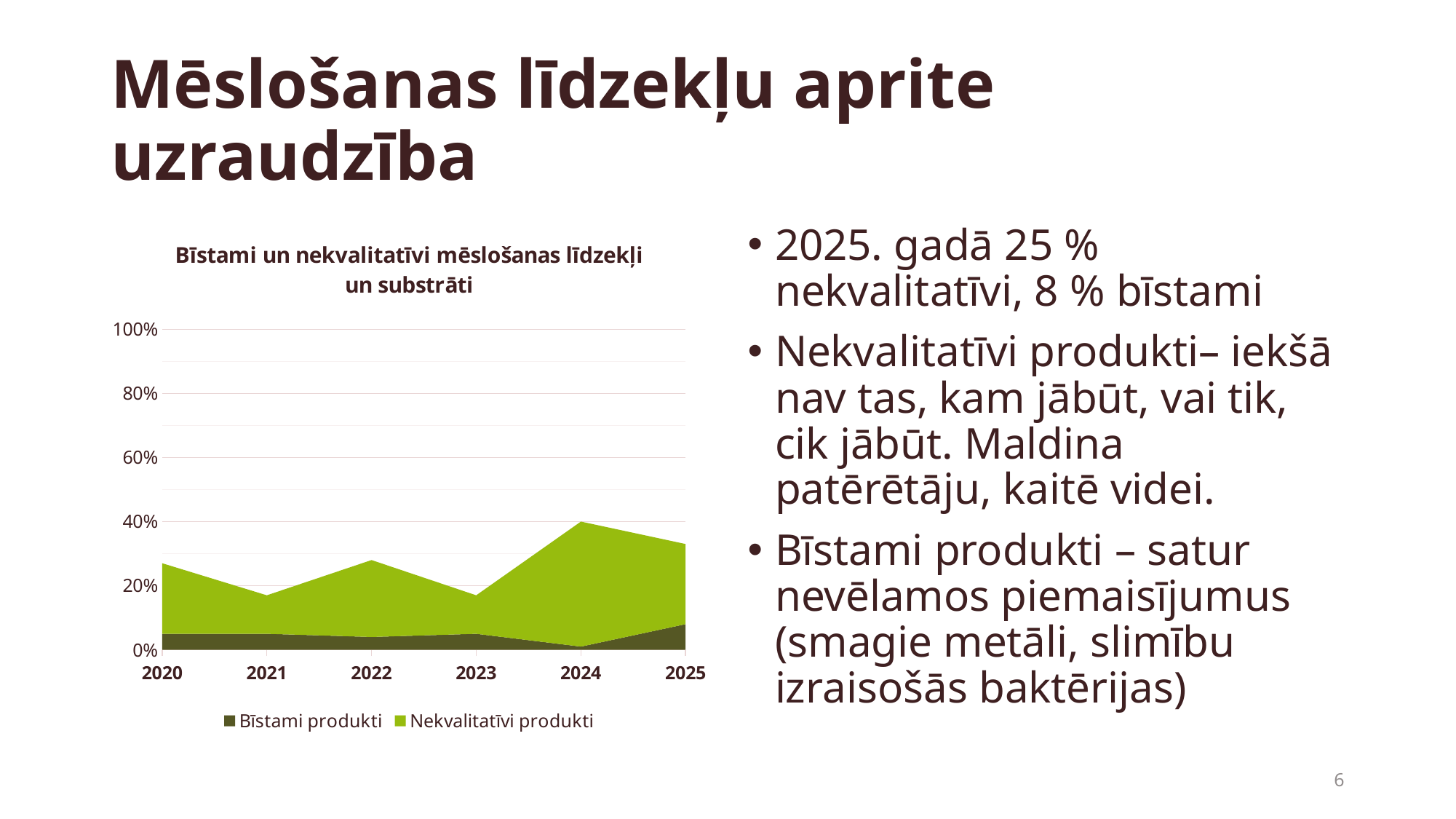
What kind of chart is shown on the slide? Area chart How many years are shown on the x axis of the chart? 6 Is the combined share of both series in 2025 greater or less than 60%? less In which year is the share of Bīstami produkti highest? 2025 In which year does the combined share of Bīstami and Nekvalitatīvi produkti reach its highest point? 2024 Does the combined share of both series rise or fall from 2023 to 2024? Rise Which series is shown in dark colour in the chart? Bīstami produkti What is the title of the chart? Bīstami un nekvalitatīvi mēslošanas līdzekļi un substrāti Which year has a larger combined share of both series, 2021 or 2024? 2024 In which year is the share of Bīstami produkti lowest? 2024 How many series does the chart legend list? 2 Is the combined share of both series in 2024 greater or less than 20%? greater